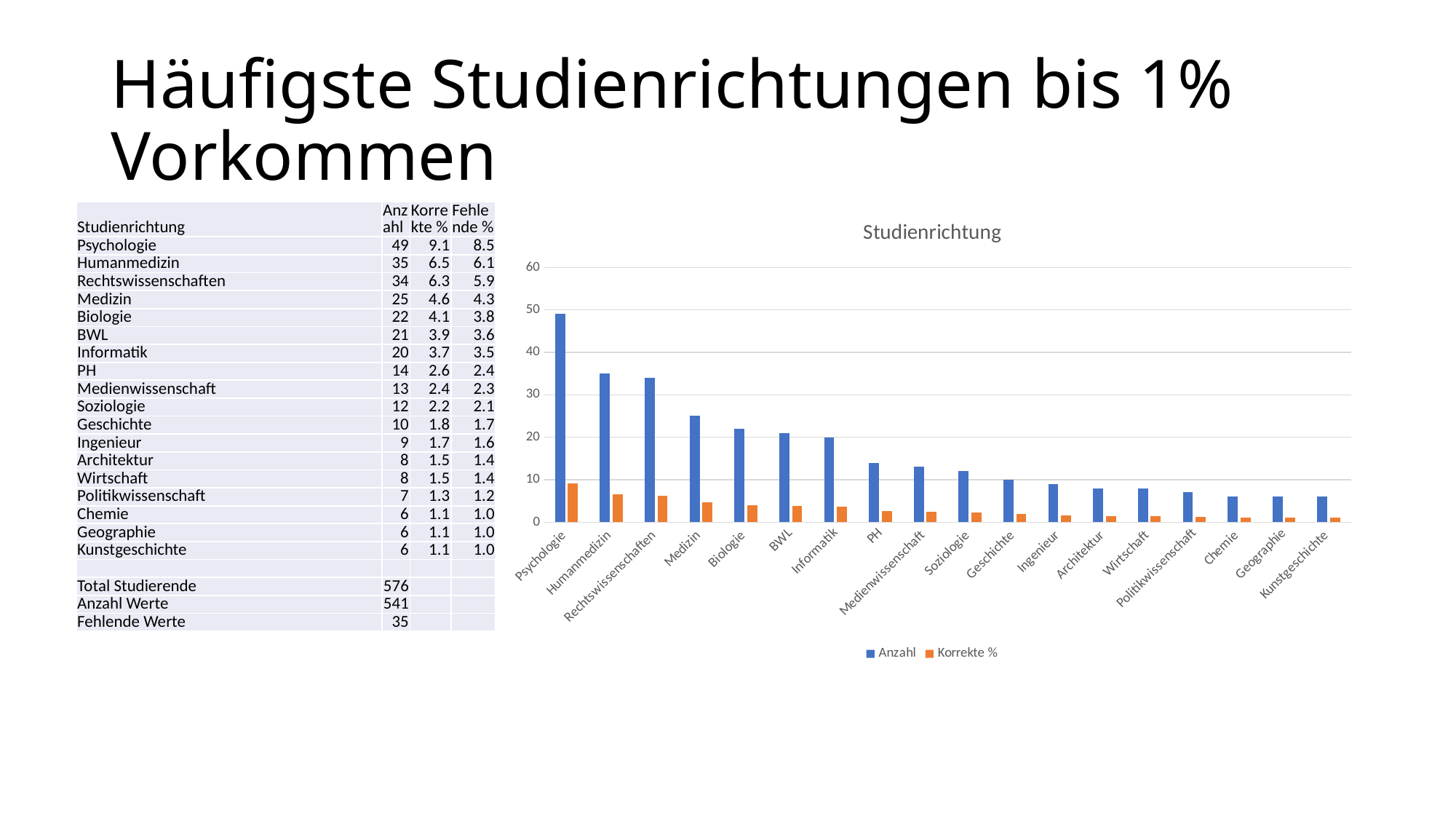
What is the title of the chart? Studienrichtung Which is larger, the Anzahl value for Humanmedizin or for Biologie? Humanmedizin How many series does the chart legend list? 2 Which category has the highest Anzahl value in the chart? Psychologie How many categories are shown on the x axis of the chart? 18 What is the Anzahl value for Psychologie? 49 What is the Korrekte % value for Humanmedizin? 6.5 What kind of chart is shown on the slide? bar chart Is the Anzahl value for Psychologie greater or less than 40? greater What is the Anzahl value for Medizin? 25 Is the Anzahl value for Geschichte greater or less than 20? less What is the difference between the Anzahl values for Psychologie and Humanmedizin? 14